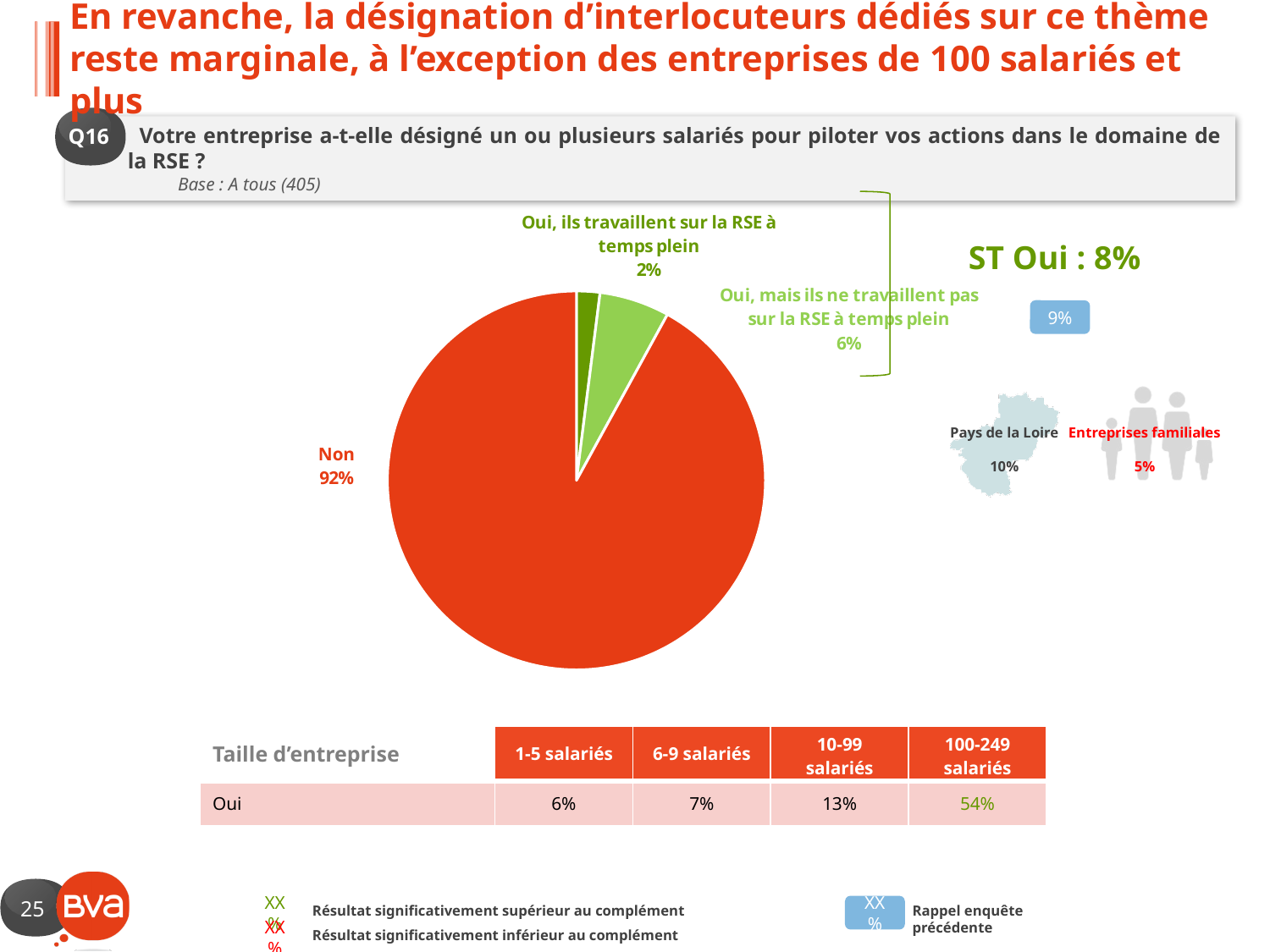
What colour is the "Non" slice of the pie chart? red What is the difference between the "Non" slice and the "Oui, mais ils ne travaillent pas sur la RSE à temps plein" slice? 86 percentage points How many slices does the pie chart have? 3 What is the combined share of the two "Oui" slices, as shown by the "ST Oui" label? 8% What share of the pie does the slice "Oui, ils travaillent sur la RSE à temps plein" represent? 2% Which is larger: the slice for "Oui, ils travaillent sur la RSE à temps plein" or the slice for "Oui, mais ils ne travaillent pas sur la RSE à temps plein"? Oui, mais ils ne travaillent pas sur la RSE à temps plein Which slice of the pie chart is the smallest? Oui, ils travaillent sur la RSE à temps plein What kind of chart is shown on the slide? pie chart What is the base (number of respondents) indicated for the pie chart? 405 Which slice of the pie chart is the largest? Non What share of the pie does the "Non" slice represent? 92% What share of the pie does the slice "Oui, mais ils ne travaillent pas sur la RSE à temps plein" represent? 6%